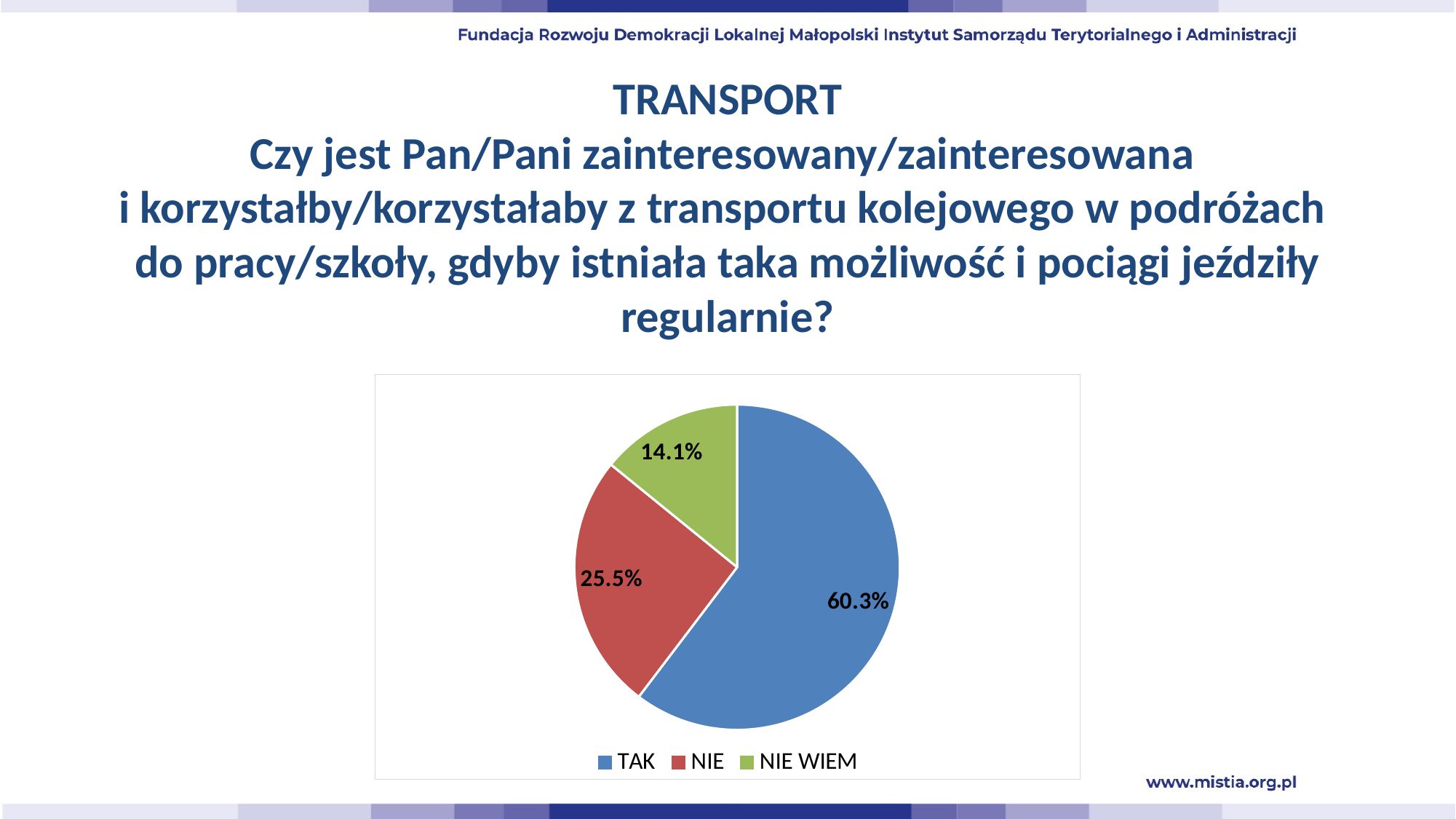
What kind of chart is shown on the slide? pie chart How many slices does the pie chart have? 3 How many entries does the legend list? 3 Which is larger, the share for NIE or the share for NIE WIEM? NIE What colour is the slice for NIE WIEM? green Which answer has the largest share of the pie? TAK What share of respondents answered NIE? 25.5% What is the difference in percentage points between NIE and NIE WIEM? 11.4 What is the difference in percentage points between TAK and NIE? 34.8 What share of respondents answered NIE WIEM? 14.1% What share of respondents answered TAK? 60.3% Which answer has the smallest share of the pie? NIE WIEM